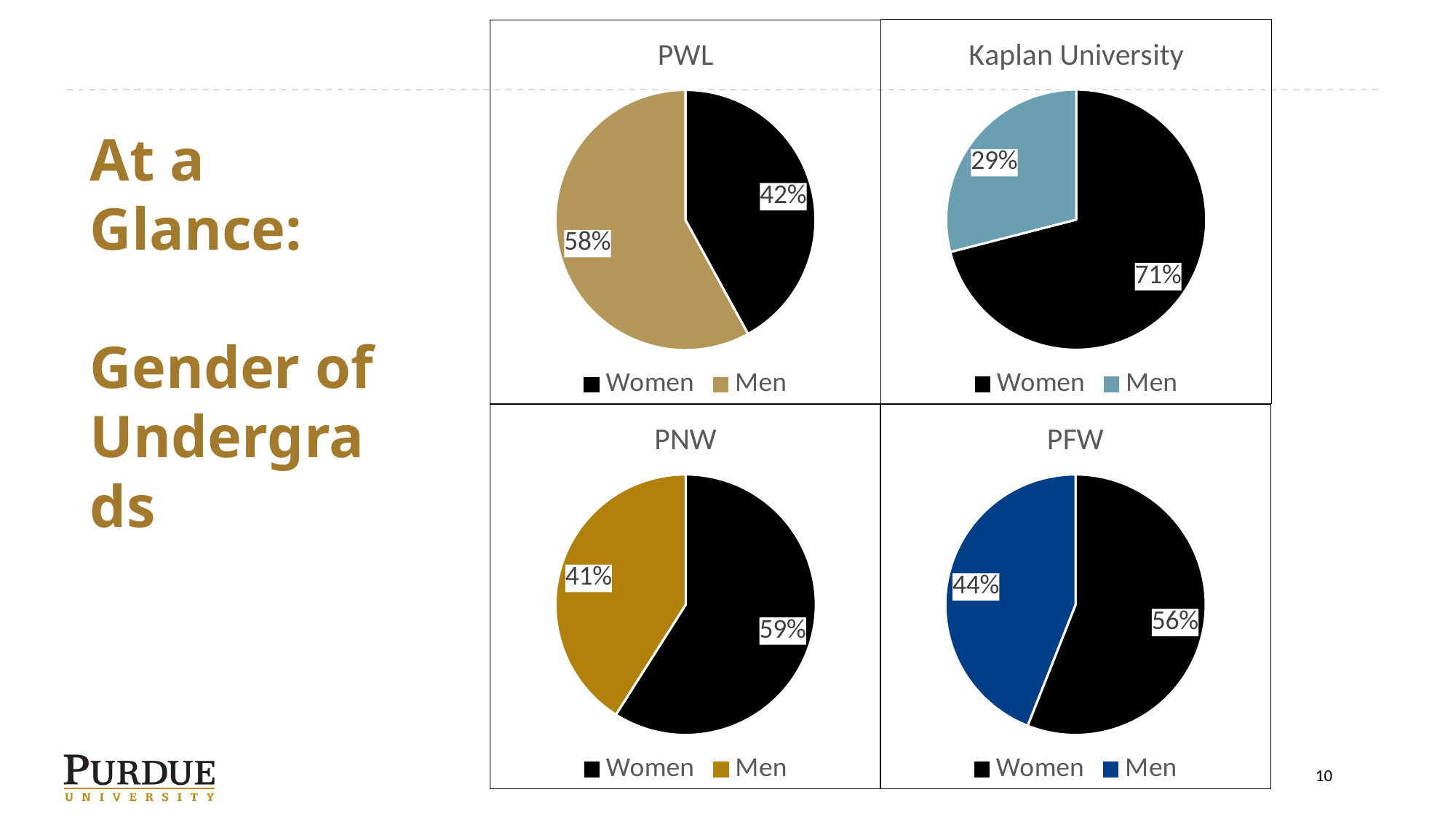
In the Kaplan University chart, what is the difference between the Women and Men percentages? 42% In the PWL chart, what percentage of undergraduates are men? 58% In the PFW chart, which slice is larger, Women or Men? Women In the PNW chart, what percentage of undergraduates are women? 59% In the PFW chart, what percentage of undergraduates are men? 44% How many entries does the legend of the PNW chart list? 2 What kind of chart is the PFW chart? Pie chart In the PWL chart, what percentage of undergraduates are women? 42% In the PNW chart, what is the difference between the Women and Men percentages? 18% In the PWL chart, which category has the largest slice? Men In the Kaplan University chart, what percentage is Men? 29% In the Kaplan University chart, what share of the pie is Women? 71%